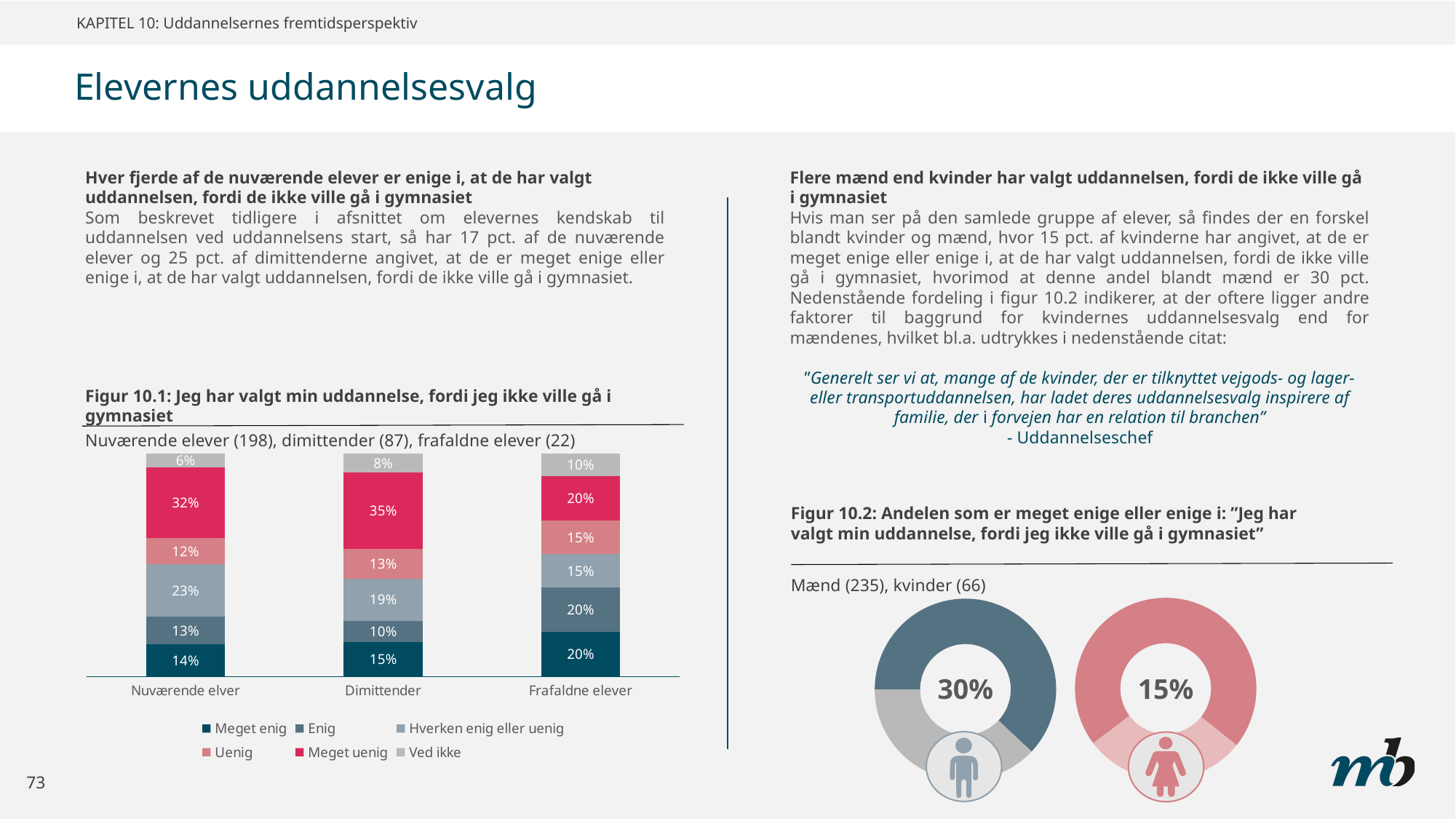
In Figur 10.1, what percentage of Frafaldne elever answered "Meget enig"? 20% How many series does the legend of Figur 10.1 list? 6 In Figur 10.1, which group has the highest share of "Meget uenig" responses? Dimittender In Figur 10.1, which is larger: the "Enig" share for Dimittender or for Frafaldne elever? Frafaldne elever In Figur 10.2, which group has the higher share: Mænd or kvinder? Mænd In Figur 10.1, what is the difference between the "Meget uenig" share for Nuværende elver and for Frafaldne elever? 12 percentage points In Figur 10.2, what share of Mænd are meget enige or enige? 30% In Figur 10.1, which group has the lowest share of "Ved ikke" responses? Nuværende elver How many groups (bars) are shown in Figur 10.1? 3 In Figur 10.1, what percentage of Nuværende elver answered "Hverken enig eller uenig"? 23% In Figur 10.1, what percentage of Dimittender answered "Meget uenig"? 35% What type of chart is Figur 10.1? Stacked bar chart